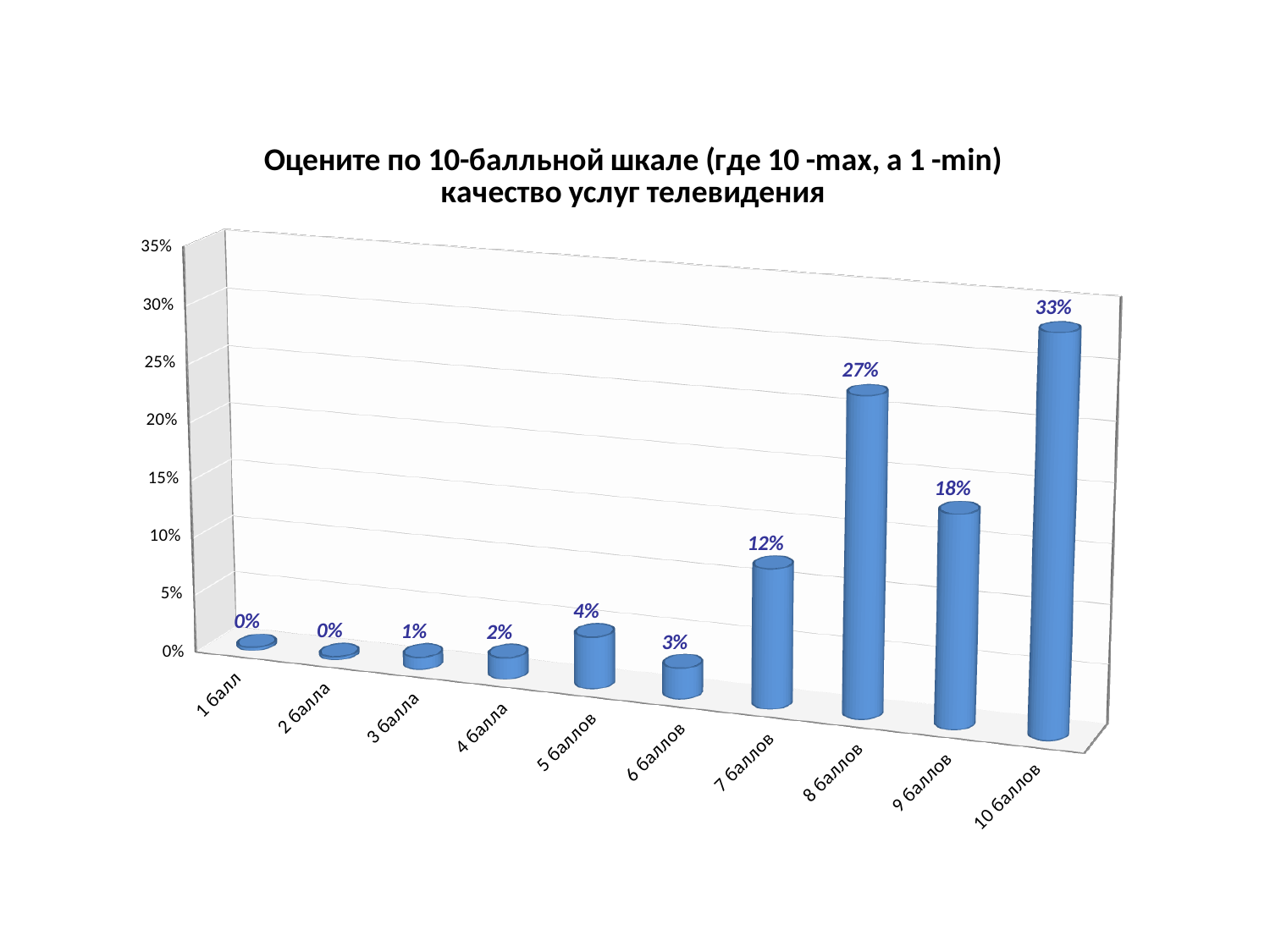
How many categories are shown on the x axis? 10 What is the difference between the values for 10 баллов and 8 баллов? 6% Which is larger, the value for 8 баллов or the value for 9 баллов? 8 баллов What is the value for 5 баллов? 4% What is the value for 7 баллов? 12% What is the difference between the values for 9 баллов and 7 баллов? 6% Which is larger, the value for 5 баллов or the value for 6 баллов? 5 баллов What is the value for 10 баллов? 33% What is the title of the chart? Оцените по 10-балльной шкале (где 10 -max, а 1 -min) качество услуг телевидения What kind of chart is shown on the slide? bar chart Which category has the highest value? 10 баллов What is the value for 8 баллов? 27%